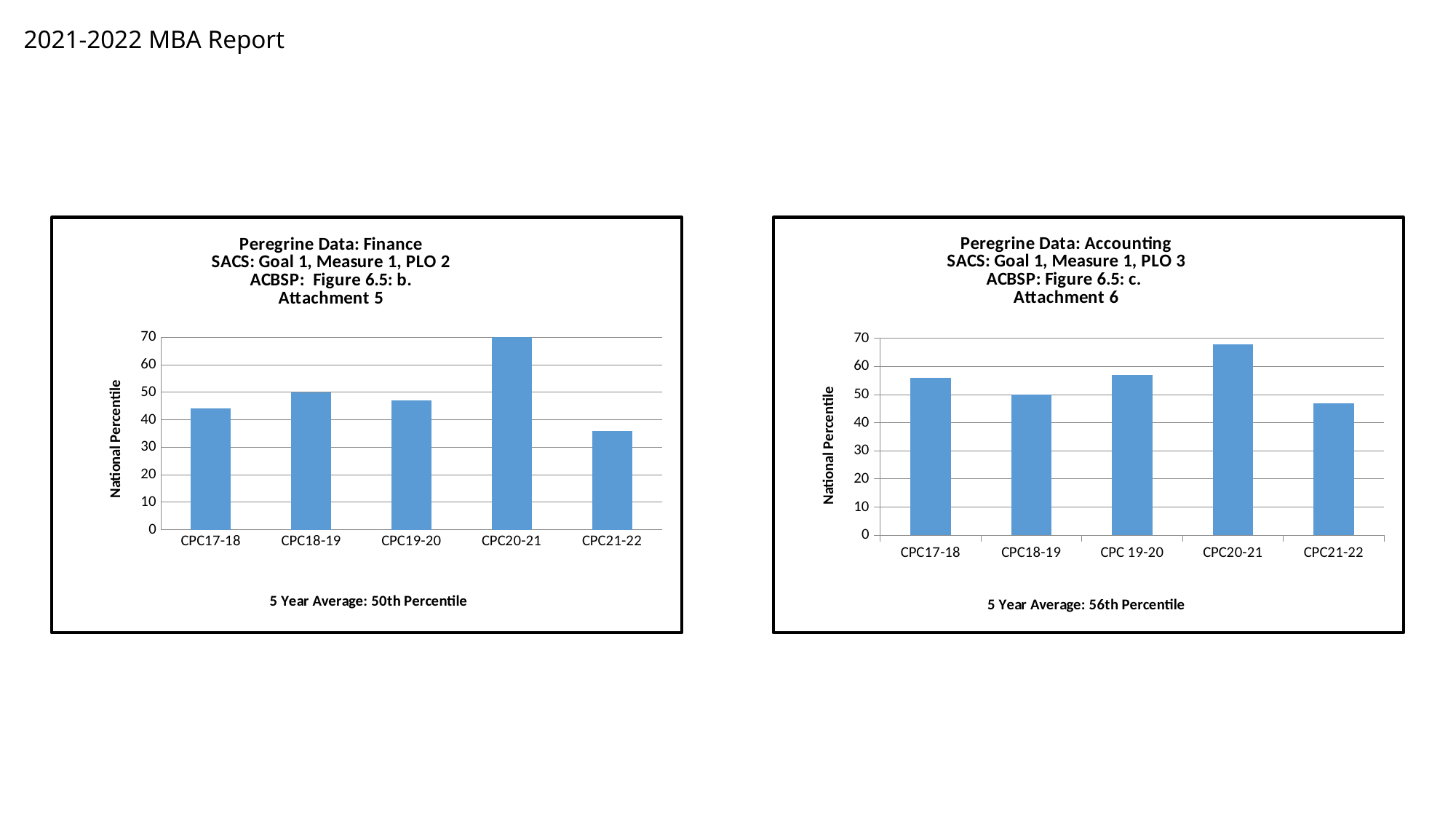
In the Peregrine Data: Finance chart, which category has the lowest national percentile? CPC21-22 In the Peregrine Data: Accounting chart, which category has the lowest national percentile? CPC21-22 What is the y-axis label on the Peregrine Data: Accounting chart? National Percentile What 5 year average is stated below the Peregrine Data: Finance chart? 50th Percentile In the Peregrine Data: Accounting chart, which is larger, the value for CPC18-19 or the value for CPC20-21? CPC20-21 How many categories are shown on the x axis of the Peregrine Data: Finance chart? 5 What kind of chart is the Peregrine Data: Finance chart? bar chart In the Peregrine Data: Accounting chart, is the value for CPC17-18 greater or less than 50? greater In the Peregrine Data: Finance chart, which category has the highest national percentile? CPC20-21 In the Peregrine Data: Finance chart, is the value for CPC21-22 greater or less than 40? less In the Peregrine Data: Accounting chart, which category has the highest national percentile? CPC20-21